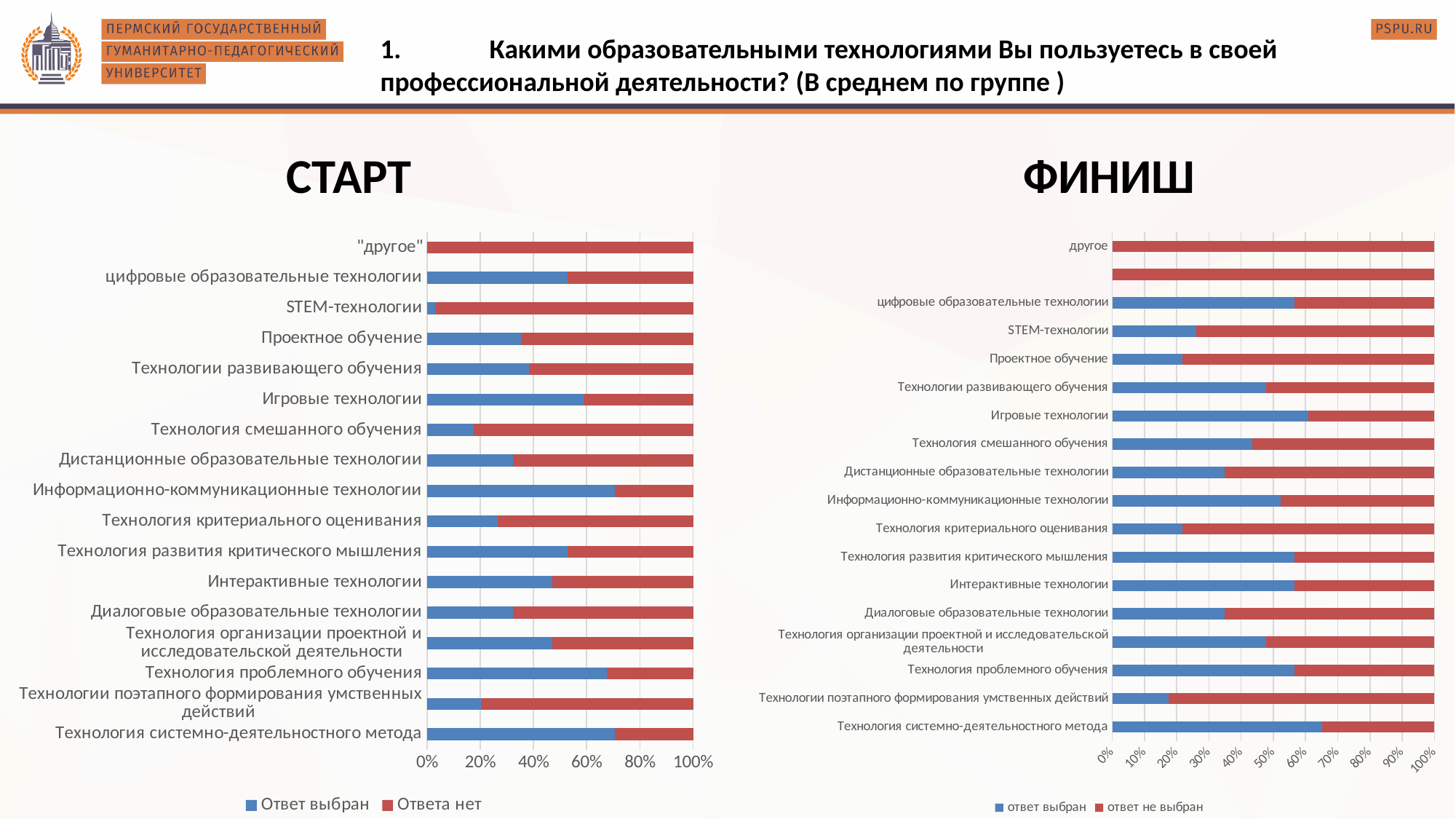
What are the two legend entries of the ФИНИШ chart? ответ выбран, ответ не выбран What kind of chart is the СТАРТ chart on the left? Stacked bar chart How many series does the legend of the СТАРТ chart list? 2 In the СТАРТ chart, is the 'Ответ выбран' share for Информационно-коммуникационные технологии greater or less than 60%? greater In the СТАРТ chart, which has the larger 'Ответ выбран' share: Информационно-коммуникационные технологии or Технология критериального оценивания? Информационно-коммуникационные технологии In the ФИНИШ chart, is the 'ответ выбран' share for Технология системно-деятельностного метода greater or less than 60%? greater In the ФИНИШ chart, which has the larger 'ответ выбран' share: Игровые технологии or Проектное обучение? Игровые технологии In the СТАРТ chart, is the 'Ответ выбран' share for STEM-технологии greater or less than 20%? less What is the title above the chart on the right side of the slide? ФИНИШ How many categories are shown on the СТАРТ chart? 17